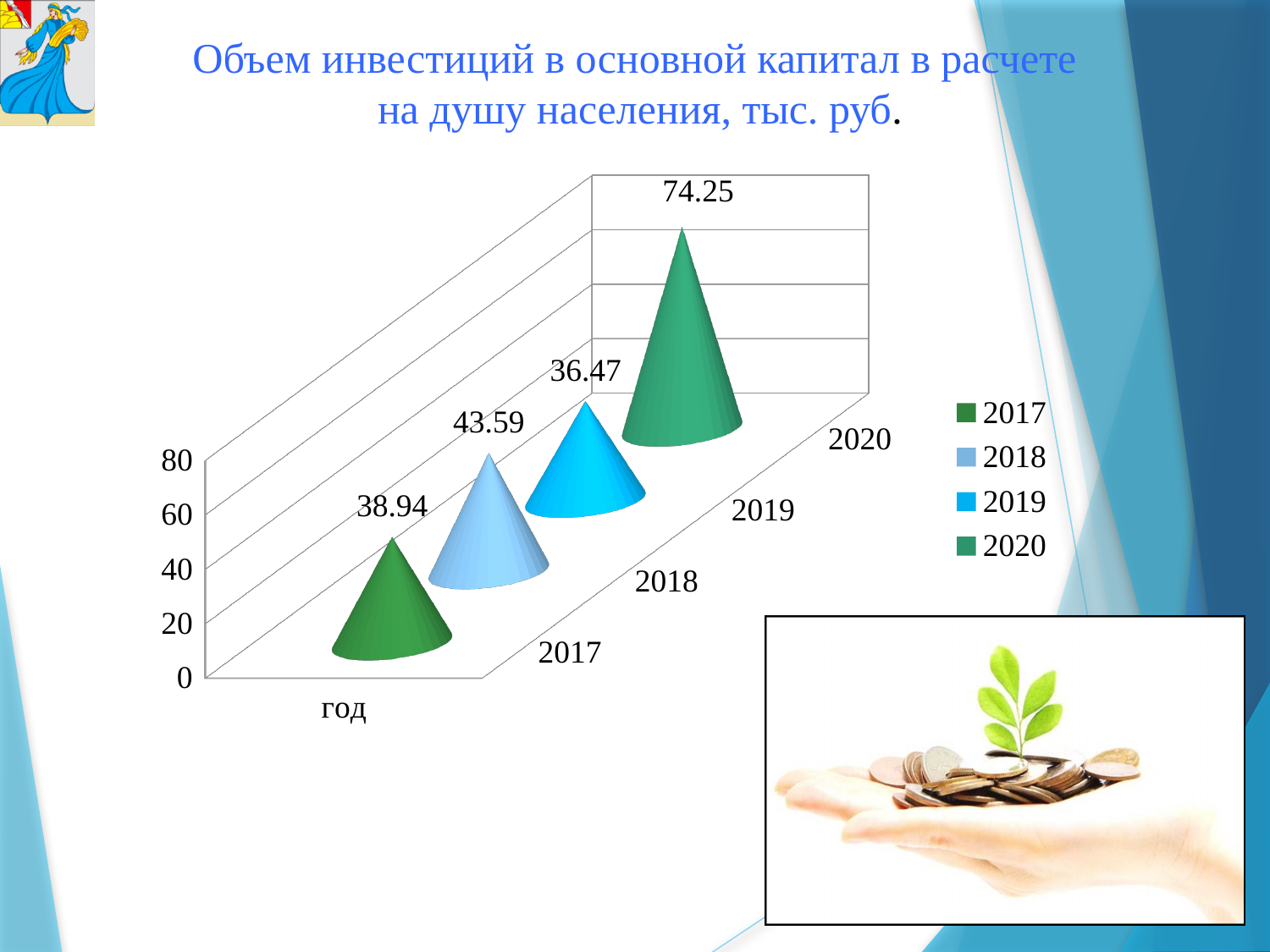
Which is larger, the value for 2018 or the value for 2019? 2018 How many entries does the legend list? 4 What is the value for 2019? 36.47 What is the value for 2017? 38.94 What is the difference between the values for 2020 and 2017? 35.31 Does the value rise or fall from 2019 to 2020? rise How many years are plotted on the chart? 4 What is the difference between the values for 2018 and 2019? 7.12 Which year has the lowest value? 2019 What is the value for 2018? 43.59 What is the value for 2020? 74.25 Which year has the highest value? 2020